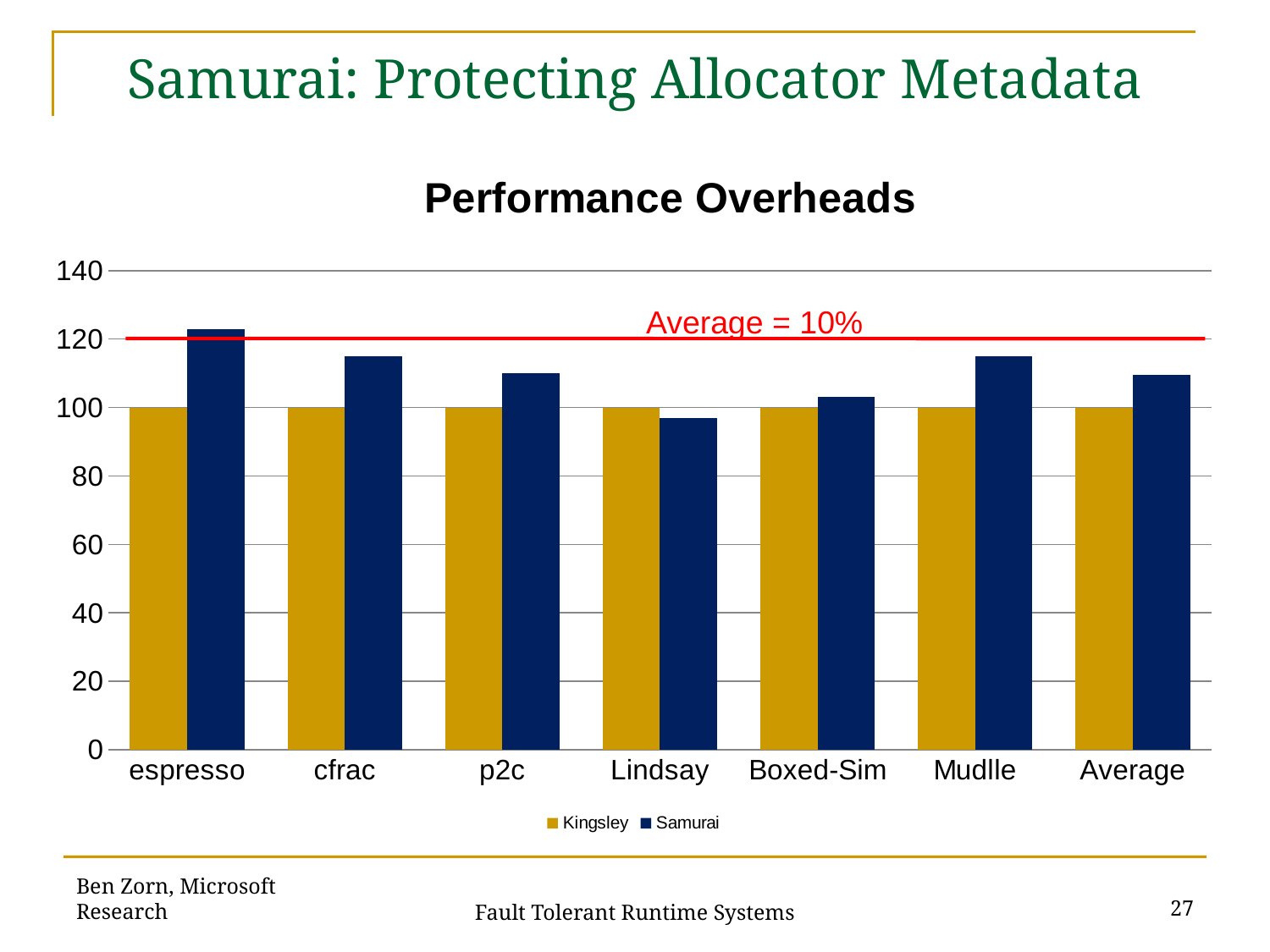
How many series does the legend list? 2 Is the Samurai value for Lindsay greater or less than 100? less For Lindsay, which series has the larger value, Kingsley or Samurai? Kingsley How many categories are shown on the x axis? 7 What does the red horizontal line on the chart indicate? Average = 10% Which category has the lowest Samurai value? Lindsay Which category has the highest Samurai value? espresso What is the title of the chart? Performance Overheads What is the Kingsley value for espresso? 100 What is the Kingsley value for Mudlle? 100 Is the Samurai value for espresso greater or less than 120? greater What kind of chart is shown on the slide? bar chart